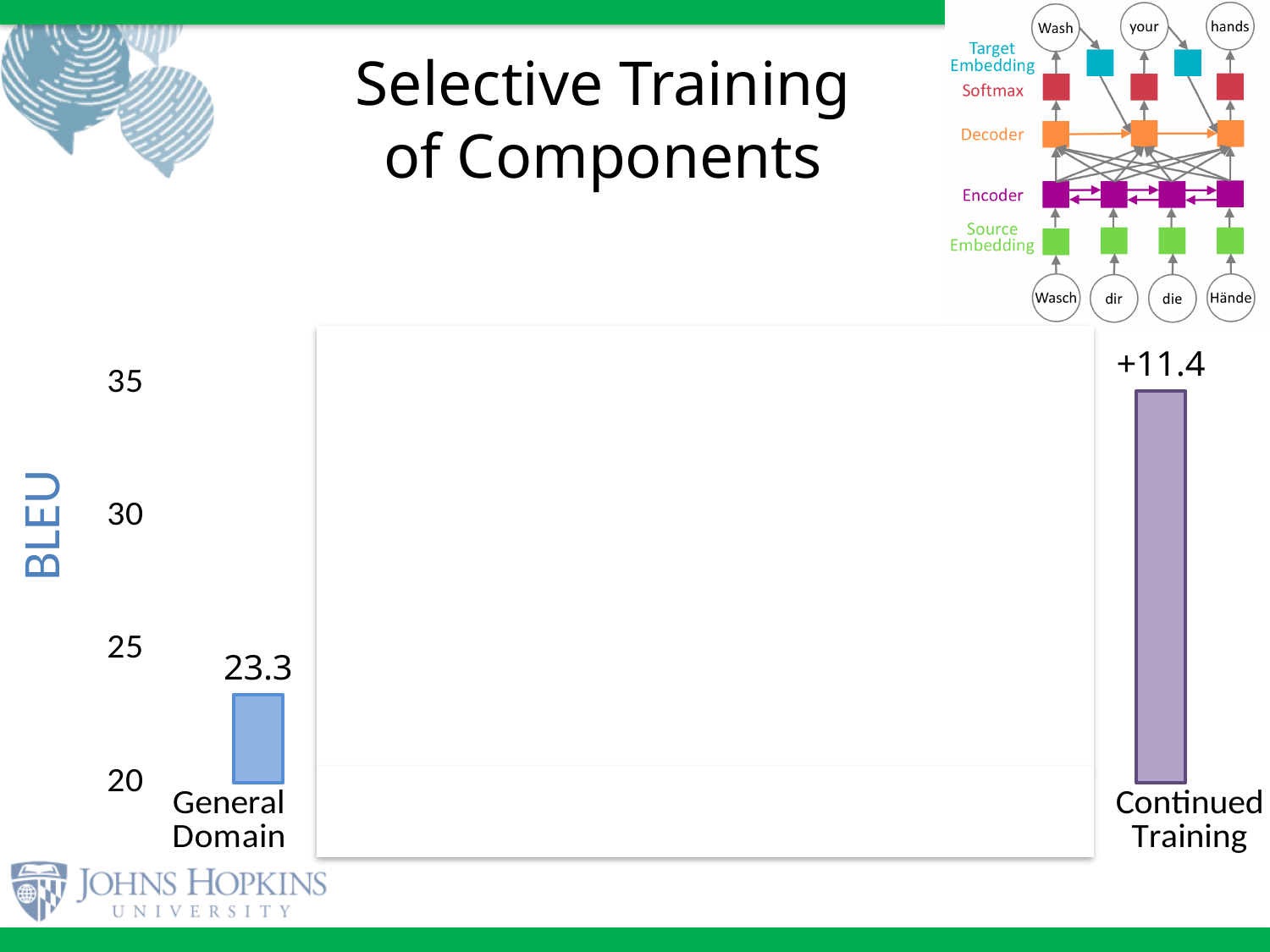
Is the value for Continued Training greater or less than 30? greater What label is printed above the Continued Training bar? +11.4 What is the title of the slide containing the chart? Selective Training of Components Which bar is higher, General Domain or Continued Training? Continued Training How many bars are visible in the chart? 2 Which visible category has the highest BLEU score? Continued Training What is the label on the y axis of the chart? BLEU According to the label on the slide, by how much does Continued Training improve over General Domain? +11.4 Which visible category has the lowest BLEU score? General Domain What BLEU value is shown for General Domain? 23.3 What kind of chart is shown on the slide? bar chart Is the value for General Domain greater or less than 25? less